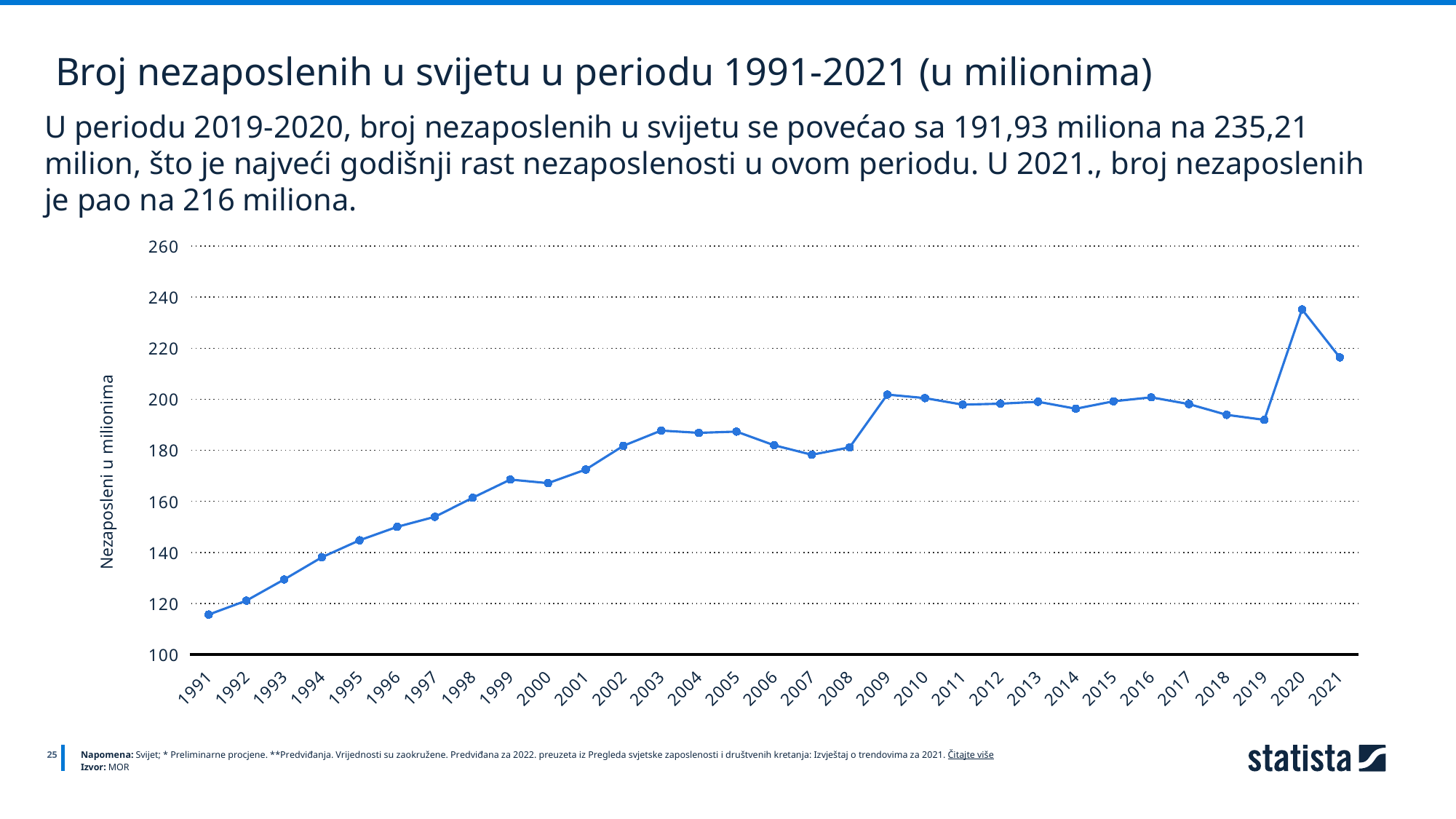
In which year is the number of unemployed highest? 2020 Is the value for 1991 greater or less than 120? less Which year has the larger value, 2020 or 2021? 2020 What is the label on the y axis of the chart? Nezaposleni u milionima How many years are plotted on the x axis of the chart? 31 Does the number of unemployed rise or fall from 1991 to 2003? rise In which year is the number of unemployed lowest? 1991 Is the value for 2003 greater or less than 180? greater According to the slide, what was the number of unemployed in the world in 2020 (in millions)? 235,21 Which year has the larger value, 1995 or 2005? 2005 What kind of chart is shown on the slide? line chart Is the value for 1999 greater or less than 160? greater